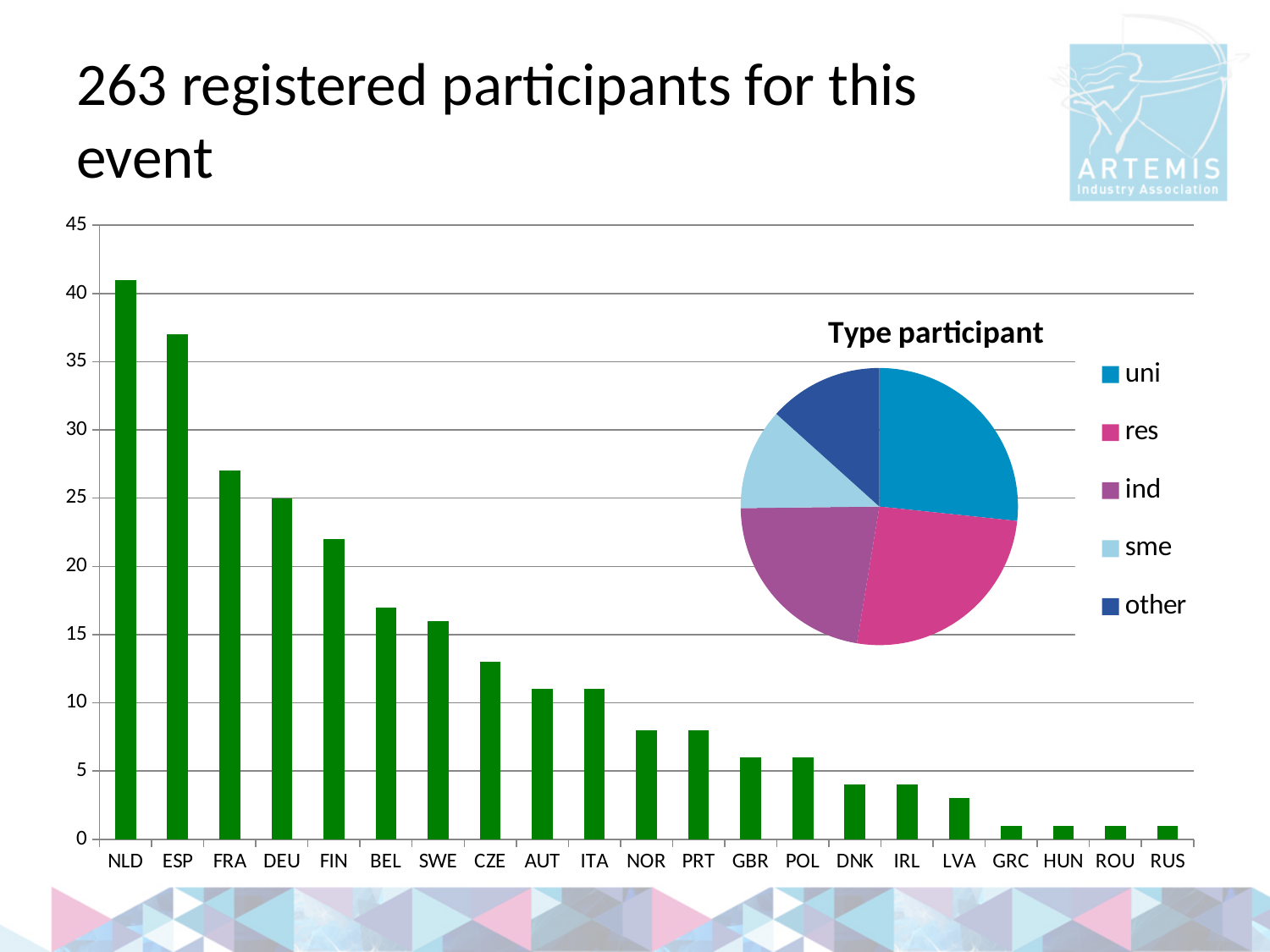
In the bar chart, which has the larger value, NOR or GBR? NOR How many entries does the legend of the 'Type participant' pie chart list? 5 In the bar chart, is the value for BEL greater or less than 20? less In the bar chart of participants by country, which country has the highest bar? NLD In the bar chart, do the values rise or fall moving from left to right along the x axis? Fall How many countries are shown on the x axis of the bar chart? 21 What is the title of the pie chart on the slide? Type participant In the bar chart, which has the larger value, ESP or FRA? ESP In the bar chart, is the value for FIN greater or less than 20? greater What kind of chart is the large chart with country codes on the x axis? Bar chart In the bar chart, is the value for ESP greater or less than 35? greater